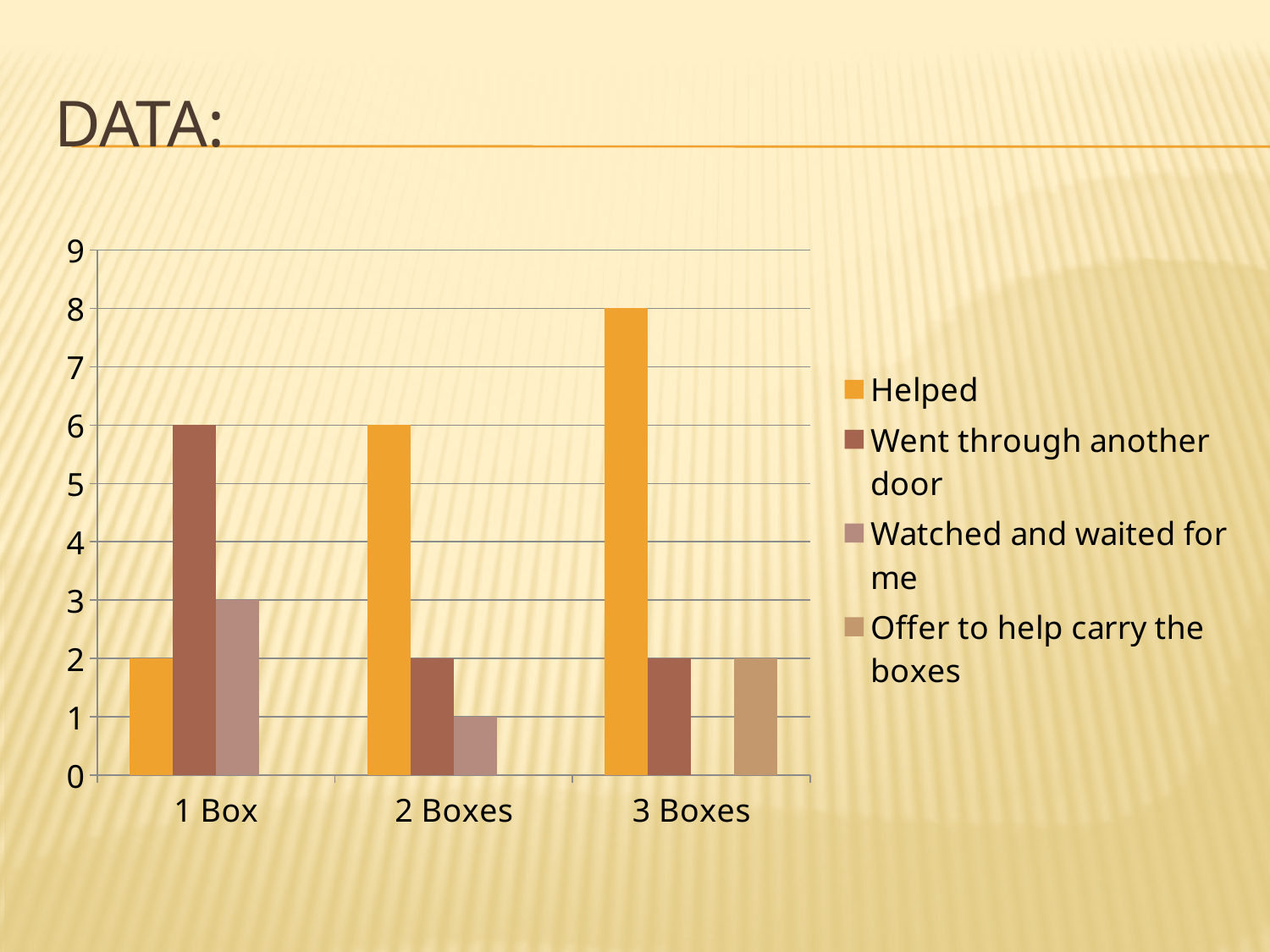
How many categories are shown on the x axis? 3 How many series does the legend list? 4 In which category is the Helped value highest? 3 Boxes What is the value for Offer to help carry the boxes in the 3 Boxes category? 2 Does the Helped value rise or fall as the number of boxes increases from 1 Box to 3 Boxes? rise What is the difference between the Helped value for 3 Boxes and the Helped value for 1 Box? 6 What is the value for Went through another door in the 1 Box category? 6 Which is larger in the 1 Box category: Helped or Went through another door? Went through another door What kind of chart is shown on the slide? bar chart What is the value for Watched and waited for me in the 2 Boxes category? 1 In which category is the Helped value lowest? 1 Box What is the value for Helped in the 3 Boxes category? 8